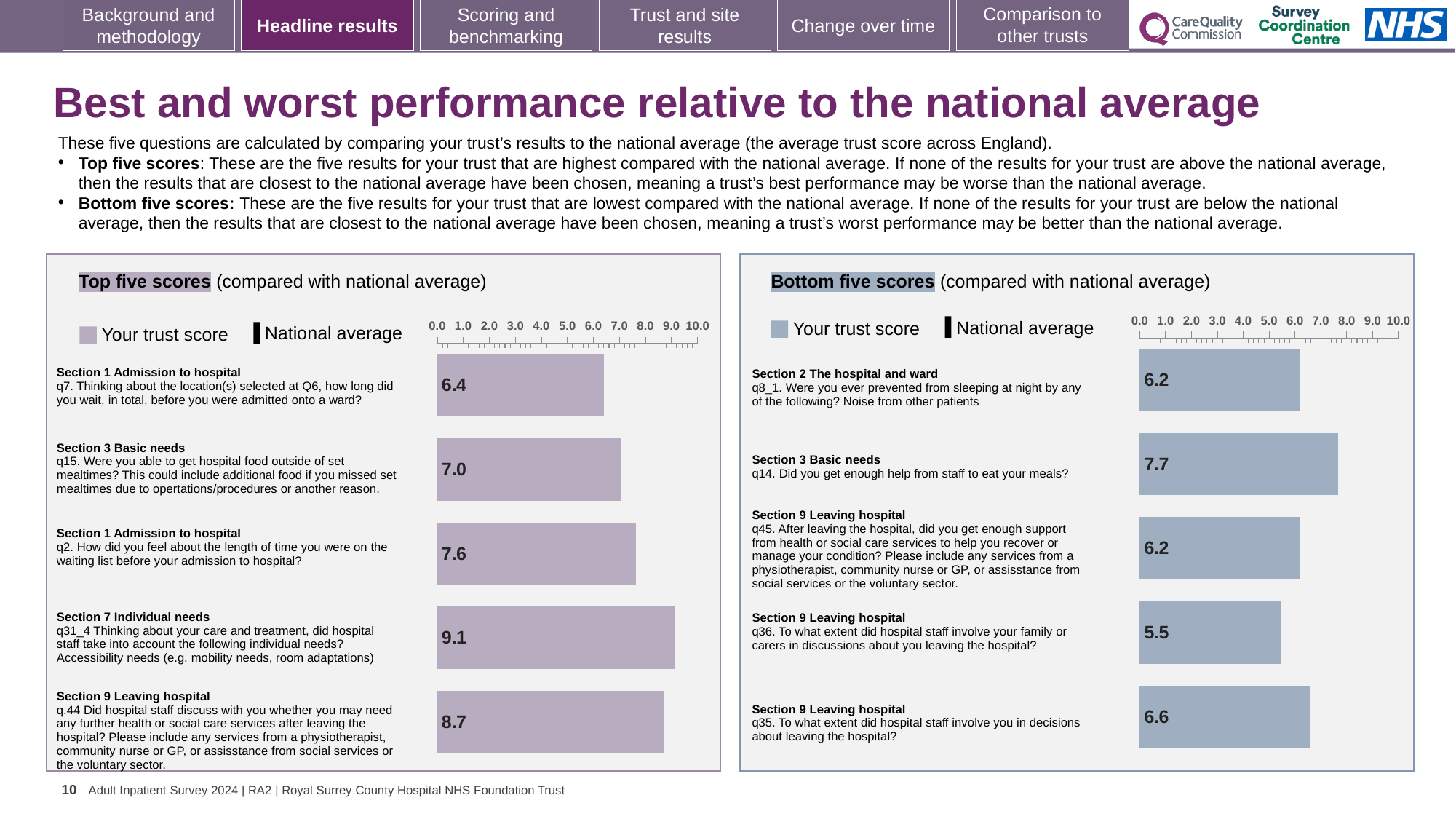
In the Bottom five scores chart, what is the difference between the trust scores for q14 and q36? 2.2 In the Bottom five scores chart, which question has the highest trust score? q14 In the Top five scores chart, what is the difference between the trust scores for q31_4 and q44? 0.4 In the Bottom five scores chart, what is the trust score for q14 (enough help from staff to eat your meals)? 7.7 In the Top five scores chart, how many questions are plotted? 5 In the Top five scores chart, which question has the lowest trust score? q7 What type of chart is used in the Top five scores panel? Bar chart In the Top five scores chart, which question has the highest trust score? q31_4 (Accessibility needs) In the Bottom five scores chart, how many series does the legend list? 2 In the Top five scores chart, what is the trust score for q7 (how long did you wait before being admitted onto a ward)? 6.4 In the Bottom five scores chart, is the trust score for q35 larger or smaller than the score for q36? larger In the Bottom five scores chart, which question has the lowest trust score? q36